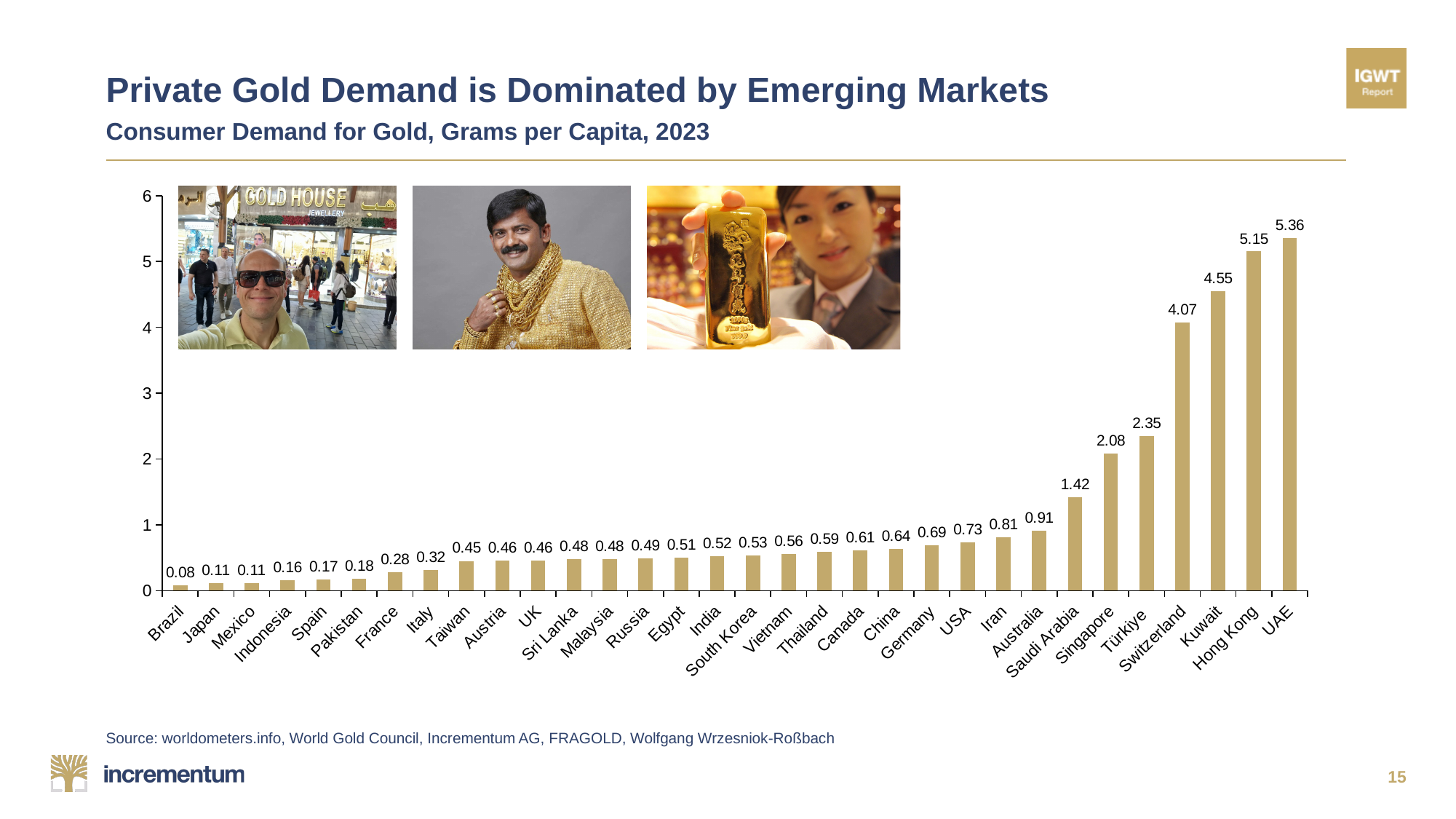
What is the difference between the values for Hong Kong and Kuwait? 0.60 Is the value for Türkiye greater or less than 2? greater Which has a higher value, Singapore or Saudi Arabia? Singapore Which country has the highest consumer demand for gold per capita? UAE What is the subtitle of the chart? Consumer Demand for Gold, Grams per Capita, 2023 What is the consumer demand for gold in grams per capita for UAE? 5.36 Do the values rise or fall from left to right along the x axis? Rise What is the value shown for Switzerland? 4.07 What type of chart is shown on the slide? Bar chart Which country has the lowest consumer demand for gold per capita? Brazil How many countries are shown in the chart? 32 What is the value shown for India? 0.52